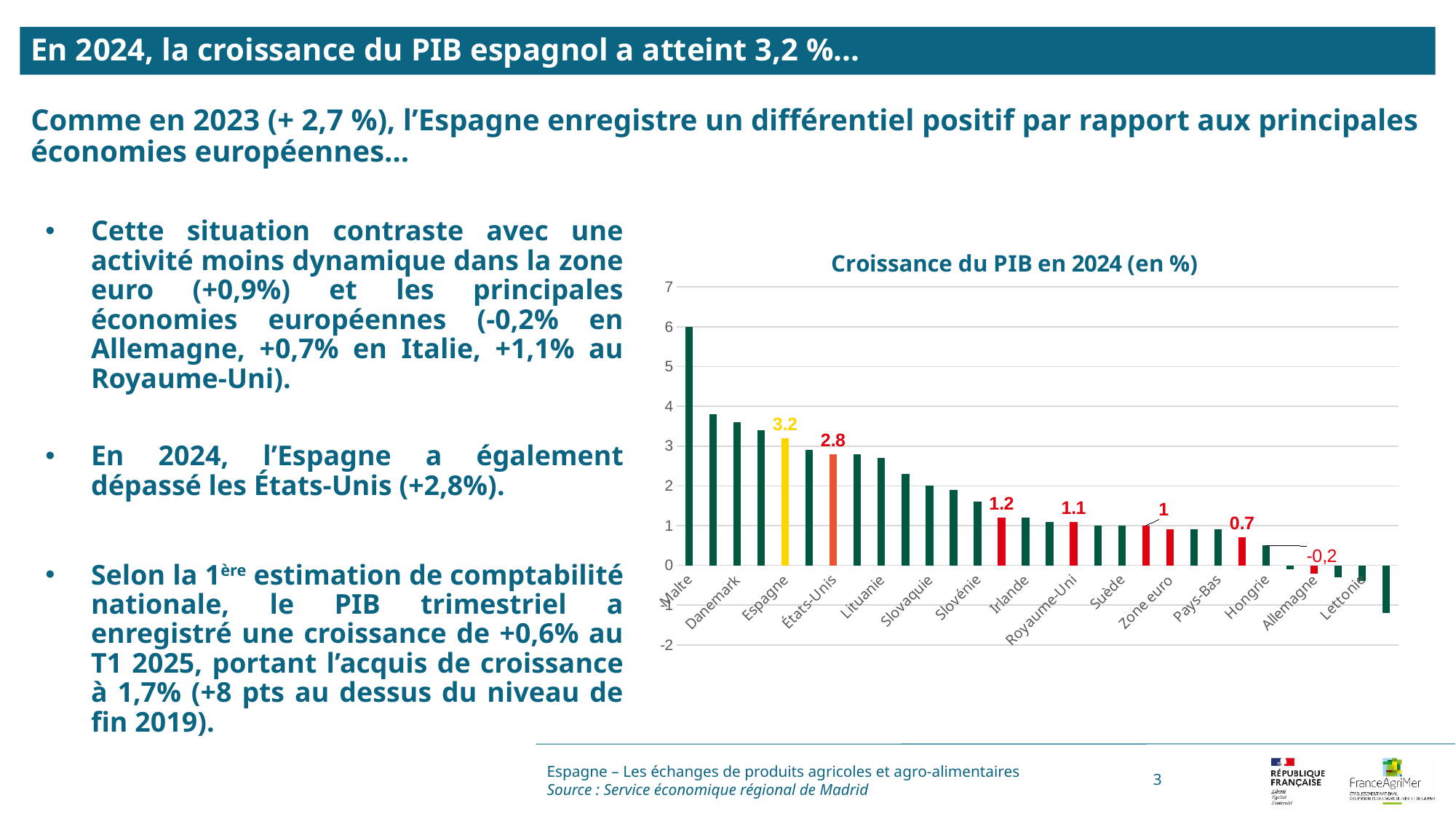
Which country has the highest GDP growth in the chart? Malte What is the value for Allemagne in the chart? -0,2 What is the difference between the values for Espagne and États-Unis? 0.4 Which is larger, the value for Irlande or the value for Royaume-Uni? Irlande What kind of chart is shown on the slide? bar chart Do the values generally rise or fall from left to right along the x axis? fall What is the value for Espagne in the chart? 3.2 What is the value for États-Unis in the chart? 2.8 Is the value for Malte greater or less than 5? greater What is the title of the chart? Croissance du PIB en 2024 (en %)